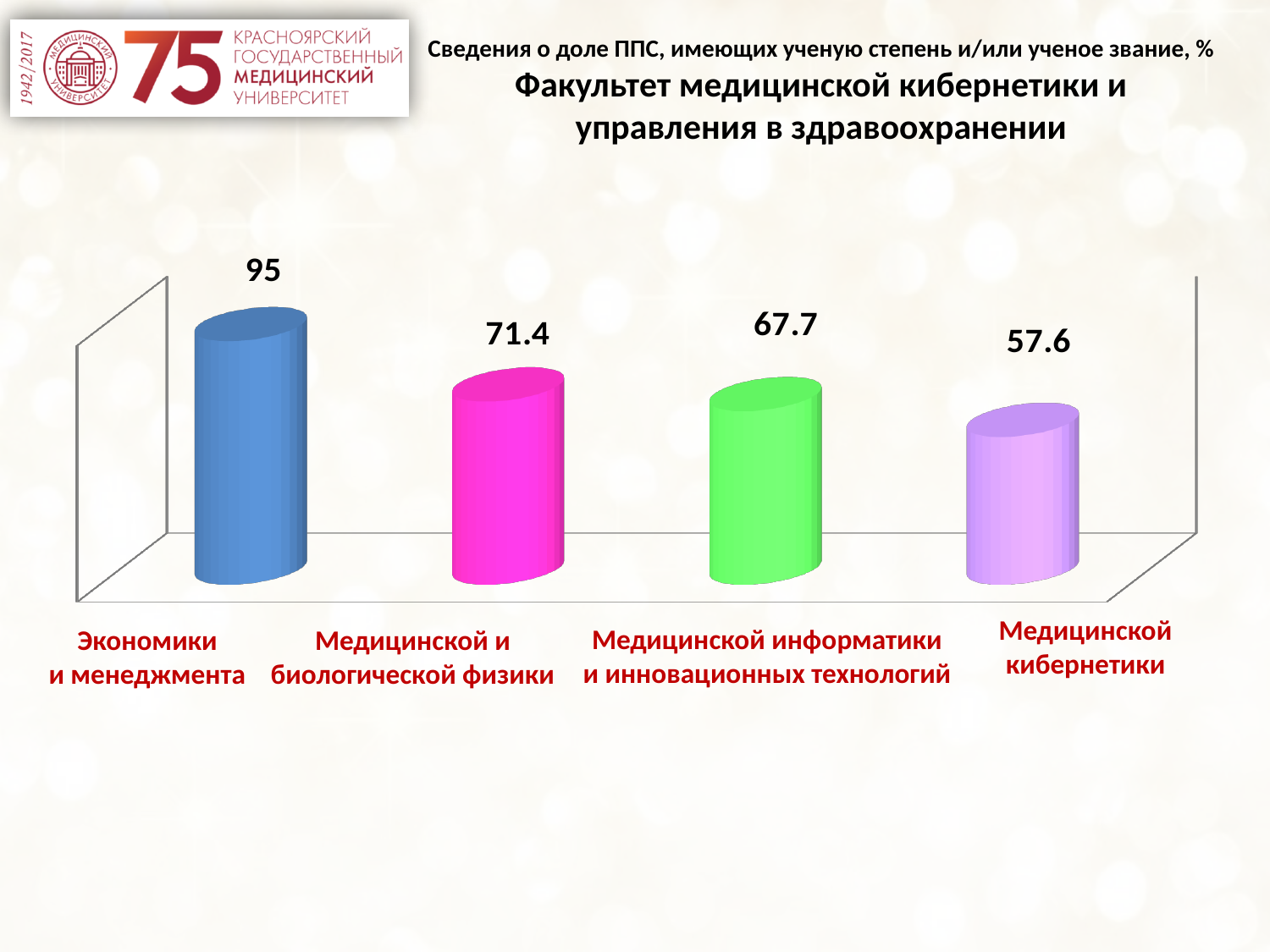
How many departments are shown in the chart? 4 What is the value for Экономики и менеджмента? 95 What is the value for Медицинской и биологической физики? 71.4 Do the values rise or fall from left to right across the chart? Fall Which department has the highest value? Экономики и менеджмента Which department has the lowest value? Медицинской кибернетики What is the value for Медицинской информатики и инновационных технологий? 67.7 What kind of chart is shown on the slide? Bar chart What is the difference between the values for Экономики и менеджмента and Медицинской кибернетики? 37.4 Which is larger, the value for Медицинской и биологической физики or the value for Медицинской кибернетики? Медицинской и биологической физики What is the value for Медицинской кибернетики? 57.6 What is the difference between the values for Медицинской и биологической физики and Медицинской информатики и инновационных технологий? 3.7